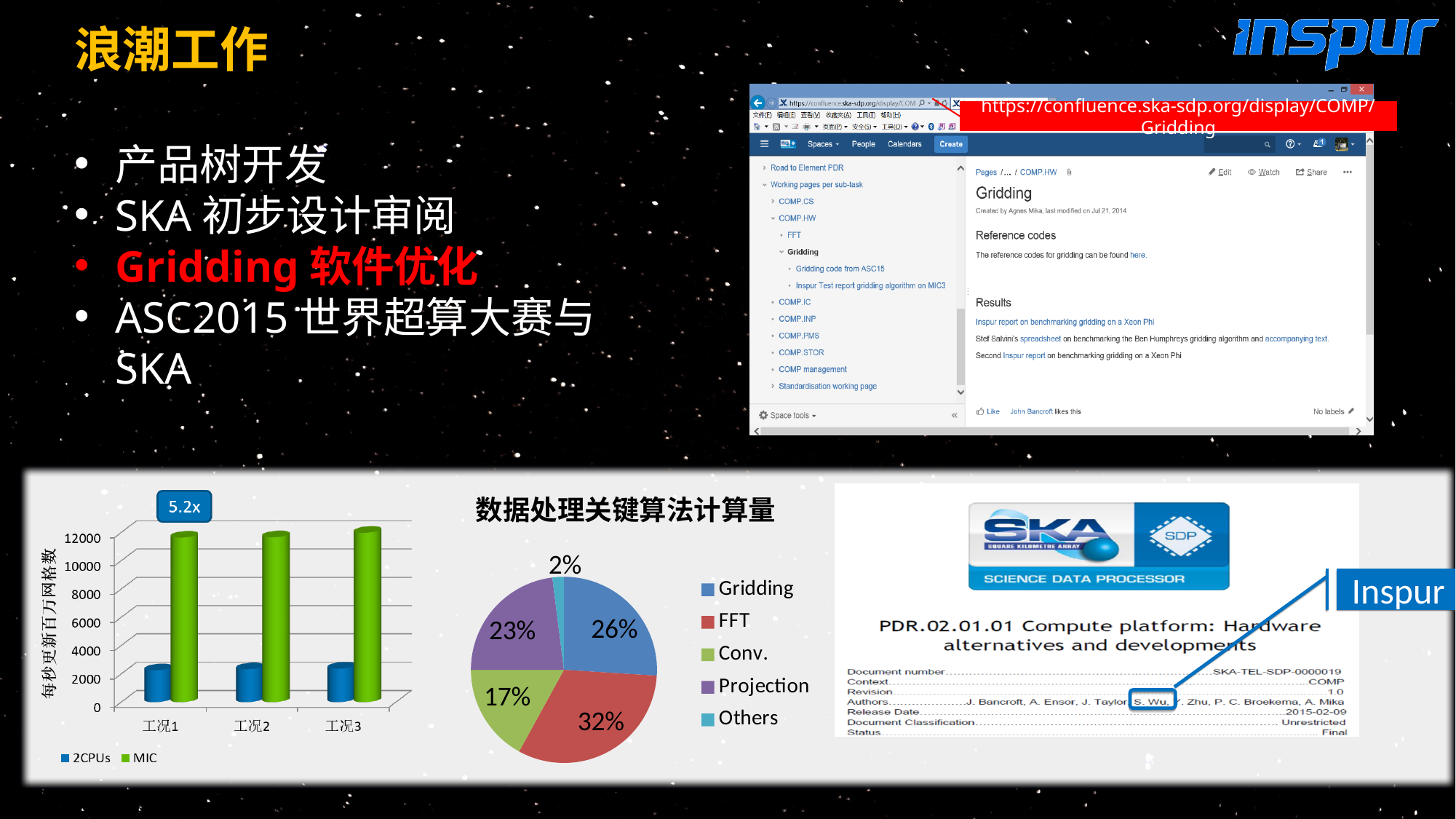
In the pie chart titled 数据处理关键算法计算量, what share does Gridding have? 26% How many categories does the legend of the pie chart titled 数据处理关键算法计算量 list? 5 In the bar chart at the bottom left, is the MIC value for 工况1 greater or less than 8000? greater In the pie chart titled 数据处理关键算法计算量, what is the difference between the FFT share and the Conv. share? 15% How many series does the legend of the bar chart at the bottom left list? 2 In the bar chart at the bottom left, which is larger for 工况2, the 2CPUs value or the MIC value? MIC In the pie chart titled 数据处理关键算法计算量, which is larger, the Gridding share or the Projection share? Gridding In the pie chart titled 数据处理关键算法计算量, what share does FFT have? 32% In the pie chart titled 数据处理关键算法计算量, which category has the largest share? FFT In the pie chart titled 数据处理关键算法计算量, what share does Projection have? 23% In the pie chart titled 数据处理关键算法计算量, which category has the smallest share? Others What kind of chart is the chart at the bottom left of the slide with categories 工况1, 工况2 and 工况3? bar chart